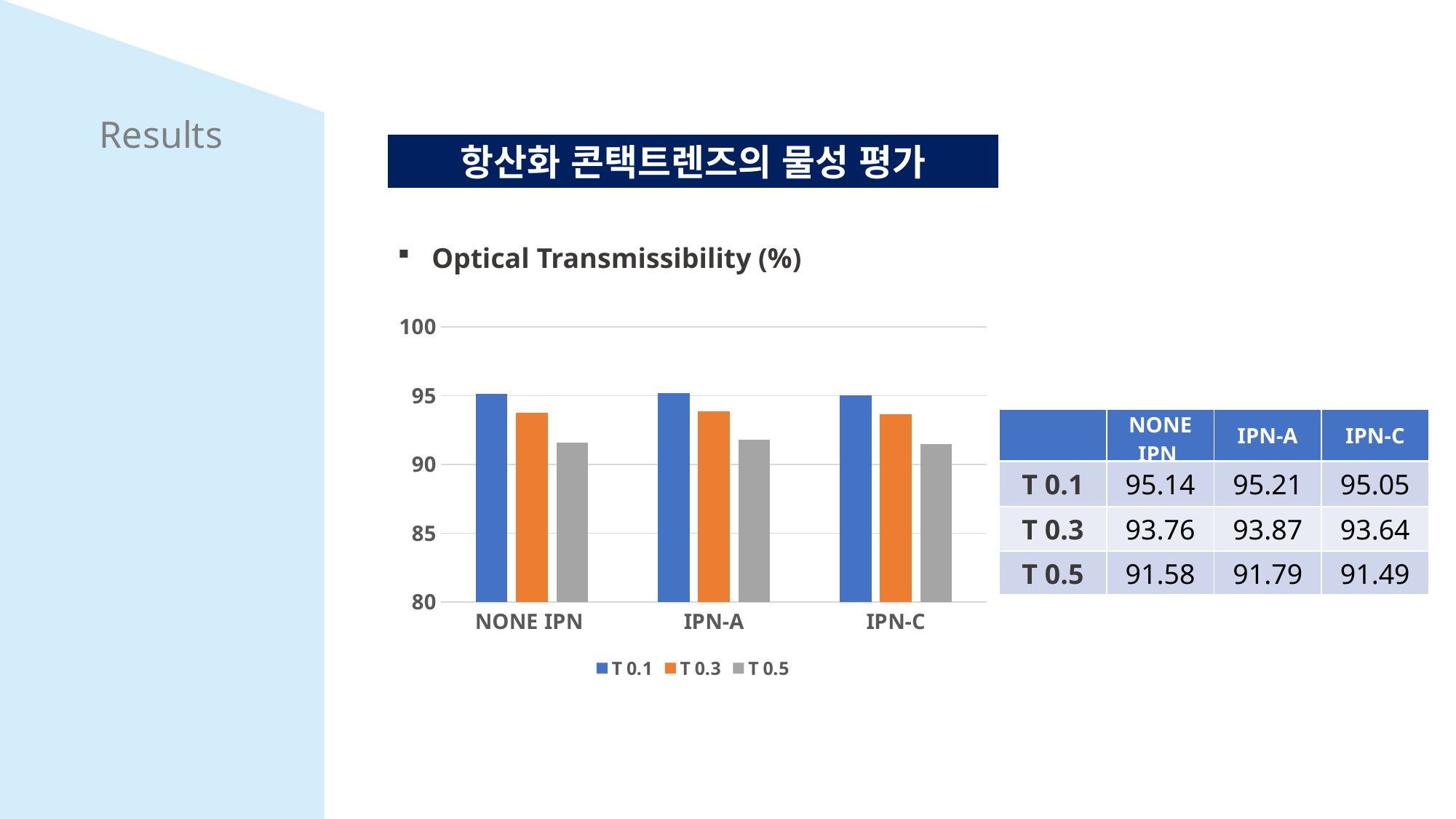
Is the T 0.5 value for IPN-C greater or less than 95? less What colour are the bars for the T 0.3 series? orange Which series has the lowest value in every category? T 0.5 What is the optical transmissibility value for T 0.5 in the NONE IPN category? 91.58 How many categories are shown on the x axis of the chart? 3 What is the optical transmissibility value for T 0.3 in the IPN-C category? 93.64 Which series has the highest value in the IPN-C category? T 0.1 How many series does the chart legend list? 3 What kind of chart is shown on the slide? bar chart Which is larger, the T 0.3 value for NONE IPN or the T 0.3 value for IPN-A? IPN-A What is the optical transmissibility value for T 0.1 in the IPN-A category? 95.21 What is the difference between the T 0.1 and T 0.5 values for IPN-A? 3.42